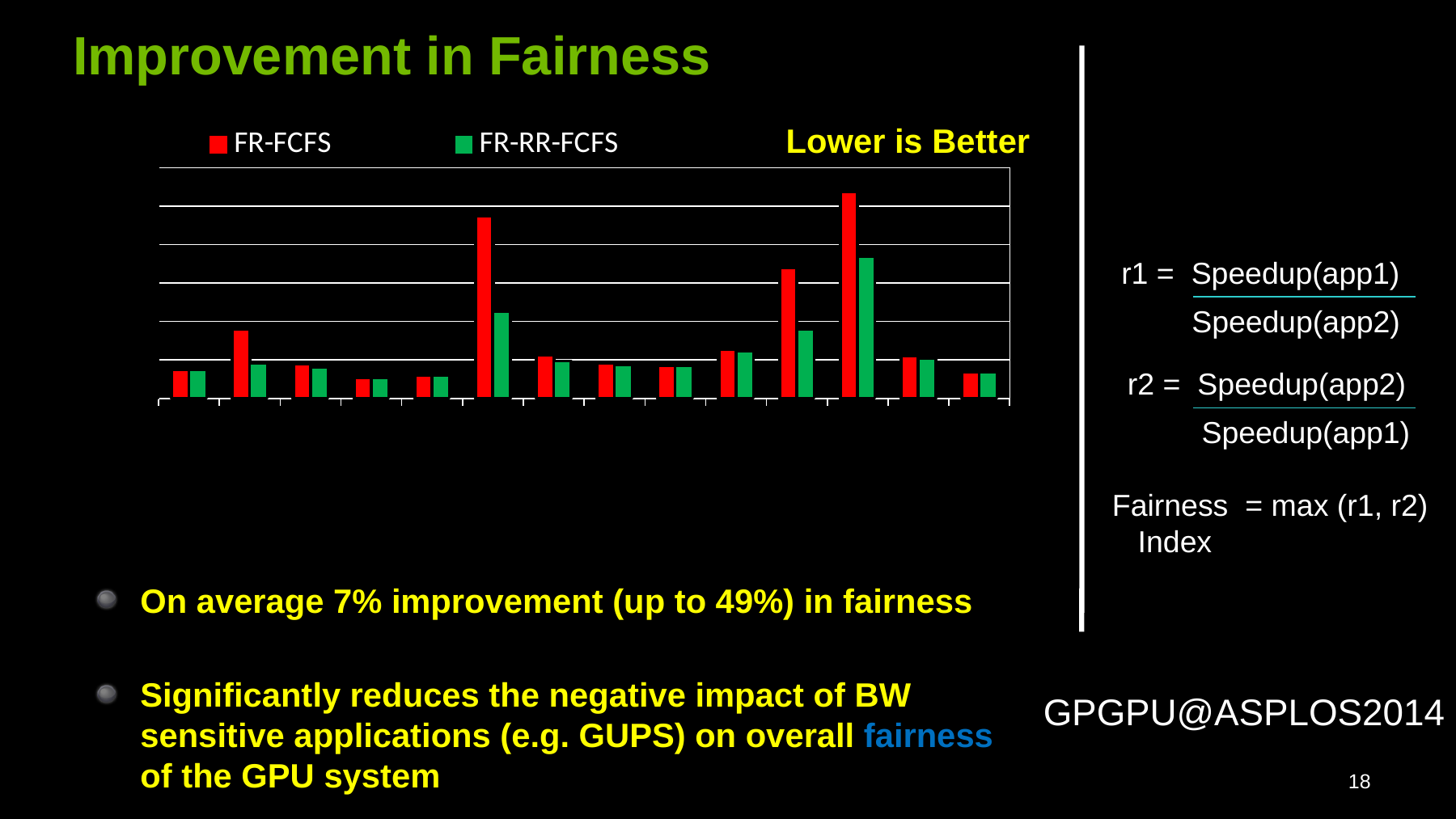
In the group with the second-tallest red bar (the sixth group from the left), which series has the larger value, FR-FCFS or FR-RR-FCFS? FR-FCFS Which series contains the tallest bar in the chart? FR-FCFS How many series does the chart's legend list? 2 What are the two series named in the chart's legend? FR-FCFS and FR-RR-FCFS In the group containing the tallest bar, which series has the larger value, FR-FCFS or FR-RR-FCFS? FR-FCFS How many groups of bars (categories) are plotted in the chart? 14 What annotation in the top right of the chart tells the reader how to interpret the values? Lower is Better What kind of chart is shown on the slide? bar chart